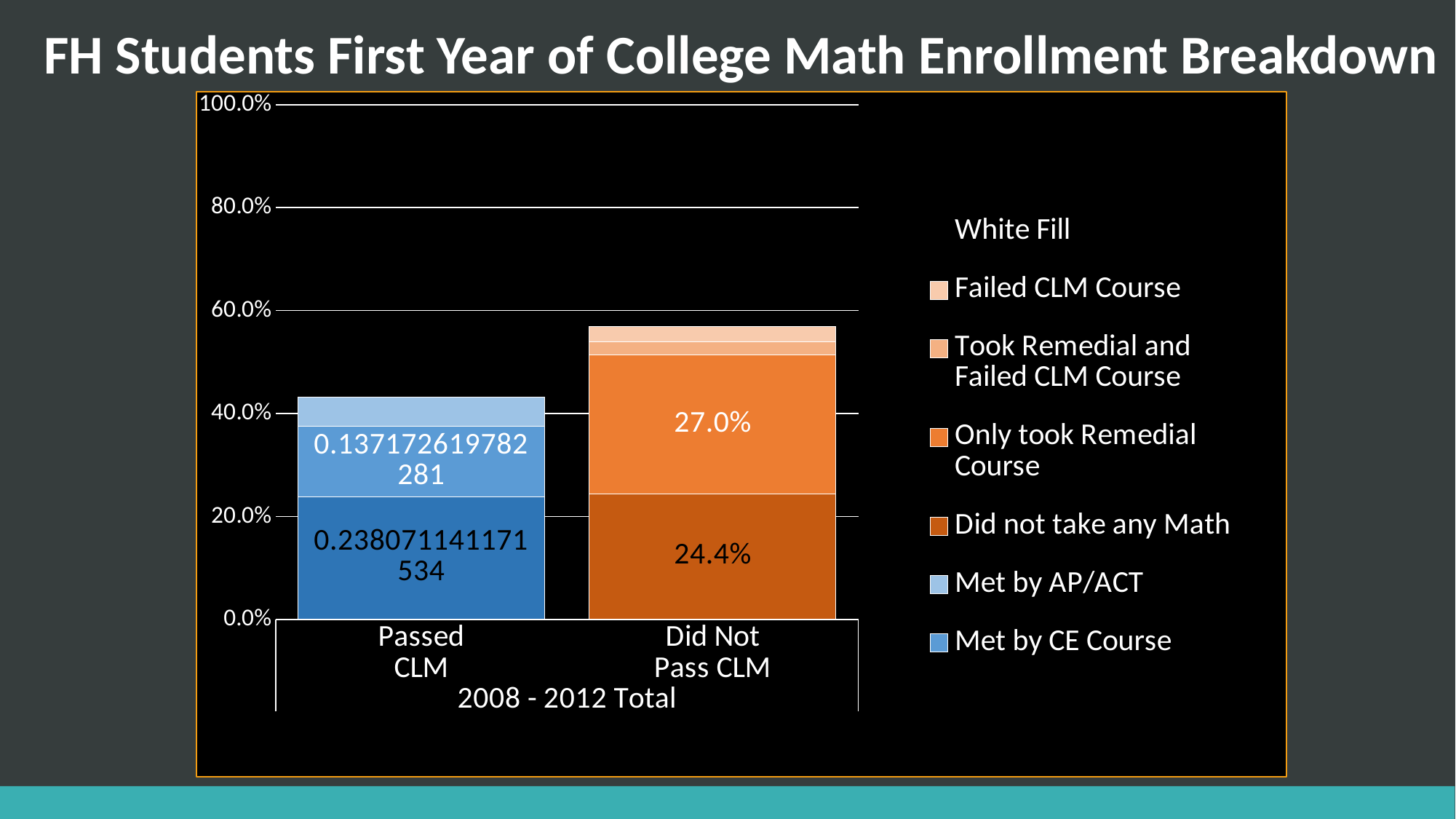
In the Did Not Pass CLM bar, which is larger: Only took Remedial Course or Did not take any Math? Only took Remedial Course Is the total height of the Did Not Pass CLM bar greater or less than 60.0%? less What kind of chart is shown on the slide? Stacked bar chart Is the total height of the Passed CLM bar greater or less than 40.0%? greater What is the difference between the Only took Remedial Course and Did not take any Math segments in the Did Not Pass CLM bar? 2.6% What percentage of Did Not Pass CLM students Only took Remedial Course? 27.0% What is the value of the Met by CE Course segment for Passed CLM? 0.137172619782281 How many categories are shown on the x axis? 2 What percentage of Did Not Pass CLM students Did not take any Math? 24.4% Which bar is taller overall, Passed CLM or Did Not Pass CLM? Did Not Pass CLM How many entries does the legend list? 7